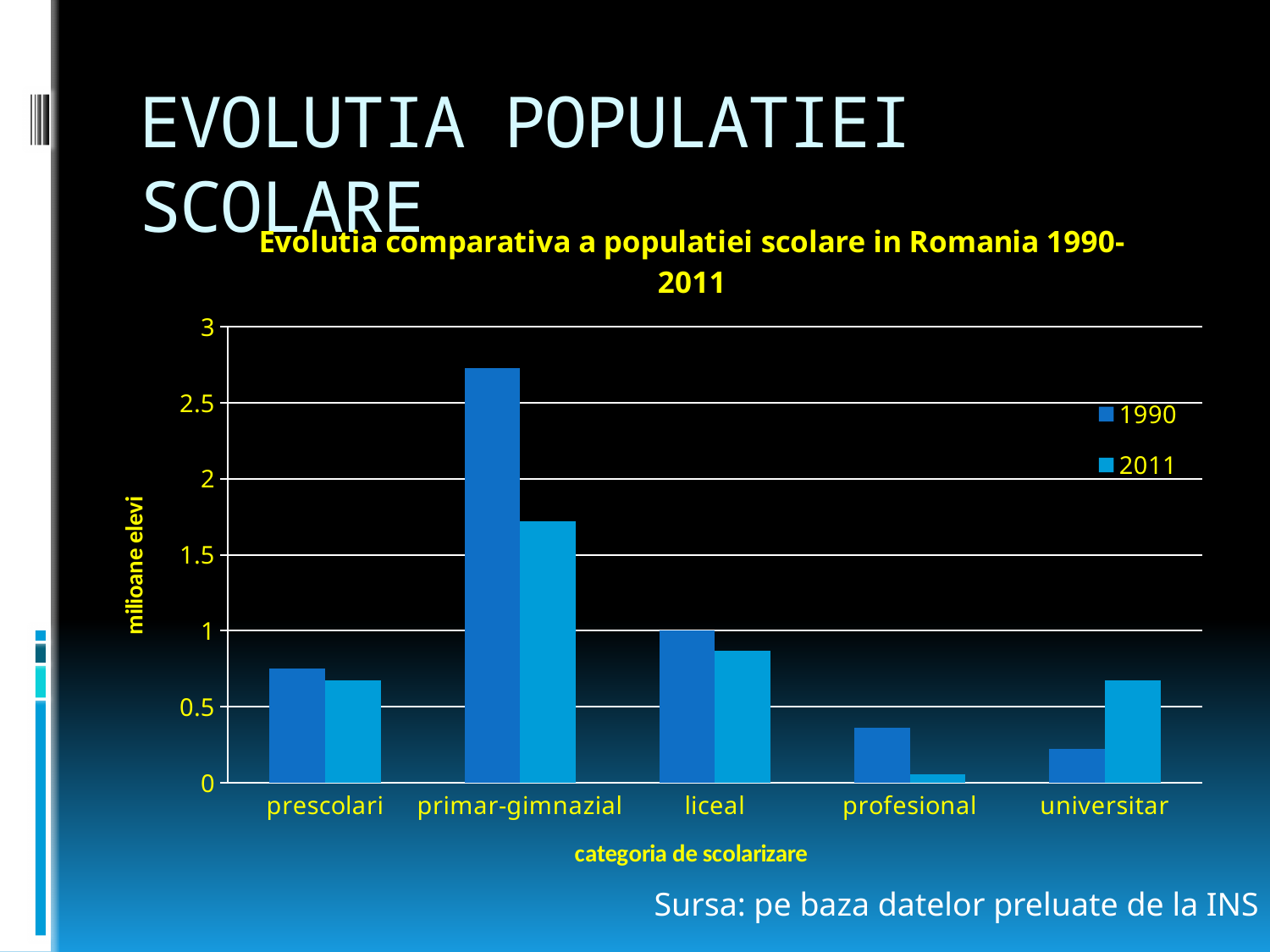
What is the label of the vertical axis? milioane elevi For universitar, which year has the larger value, 1990 or 2011? 2011 What kind of chart is shown on the slide? bar chart Which category has the highest value for 1990? primar-gimnazial Is the 1990 value for profesional greater or less than 0.5? less Is the 1990 value for primar-gimnazial greater or less than 2.5? greater Which category has the lowest value for 2011? profesional How many series does the legend list? 2 Which category has the lowest value for 1990? universitar How many categories are shown on the x axis? 5 Is the 2011 value for primar-gimnazial greater or less than 1.5? greater Which category has the highest value for 2011? primar-gimnazial